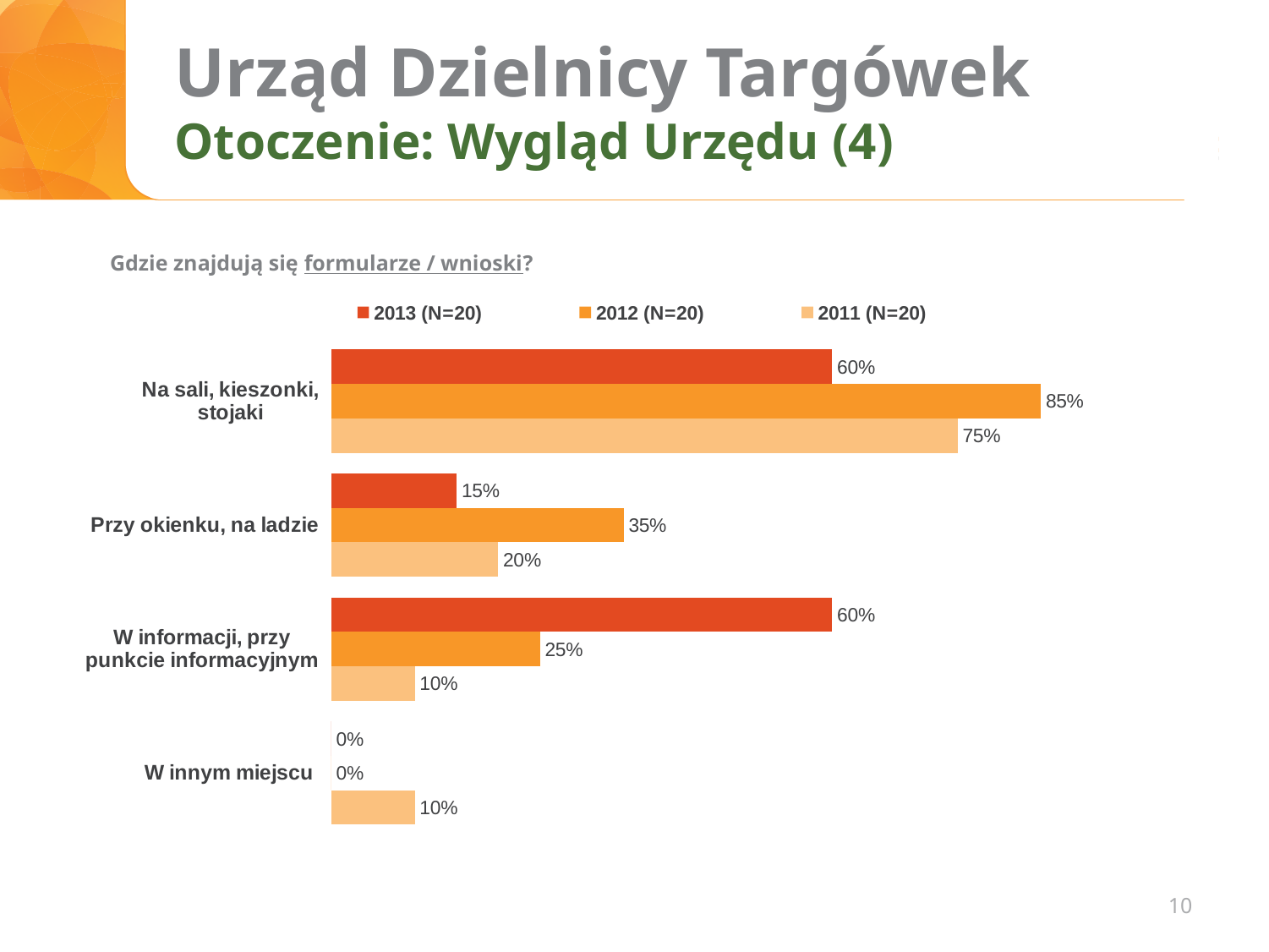
What question does the chart's title ask? Gdzie znajdują się formularze / wnioski? Which is larger for "W informacji, przy punkcie informacyjnym": the 2013 (N=20) value or the 2012 (N=20) value? 2013 (N=20) What is the value for "Na sali, kieszonki, stojaki" in the 2012 (N=20) series? 85% What is the value for "W innym miejscu" in the 2012 (N=20) series? 0% What is the value for "Przy okienku, na ladzie" in the 2013 (N=20) series? 15% What kind of chart is shown on the slide? Bar chart Which category has the highest value in the 2012 (N=20) series? Na sali, kieszonki, stojaki What is the value for "W informacji, przy punkcie informacyjnym" in the 2011 (N=20) series? 10% What is the difference between the 2012 (N=20) and 2013 (N=20) values for "Na sali, kieszonki, stojaki"? 25% How many series does the legend list? 3 How many categories are shown on the chart? 4